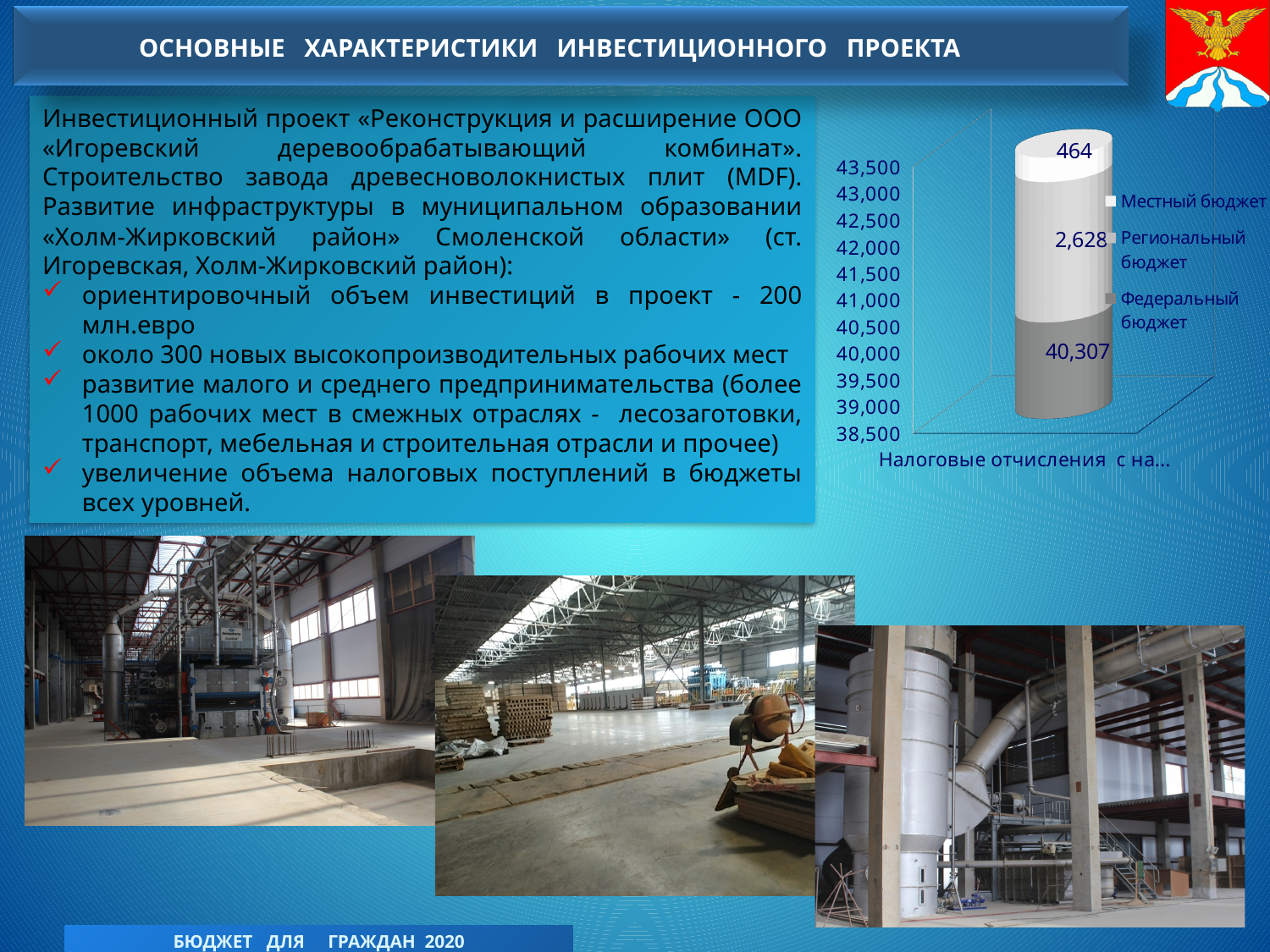
What is the lowest value shown on the chart's vertical axis? 38,500 Which budget level has the smallest value in the chart? Местный бюджет What kind of chart is shown on the slide? Stacked bar chart What is the total of the stacked bar in the chart? 43,399 What value is shown for Федеральный бюджет in the chart? 40,307 Is the total of the stacked bar greater or less than 43,000? greater Which is larger, the value for Региональный бюджет or the value for Местный бюджет? Региональный бюджет What value is shown for Региональный бюджет in the chart? 2,628 What is the difference between the values for Региональный бюджет and Местный бюджет? 2,164 What value is shown for Местный бюджет in the chart? 464 How many series does the chart legend list? 3 Which budget level has the largest value in the chart? Федеральный бюджет